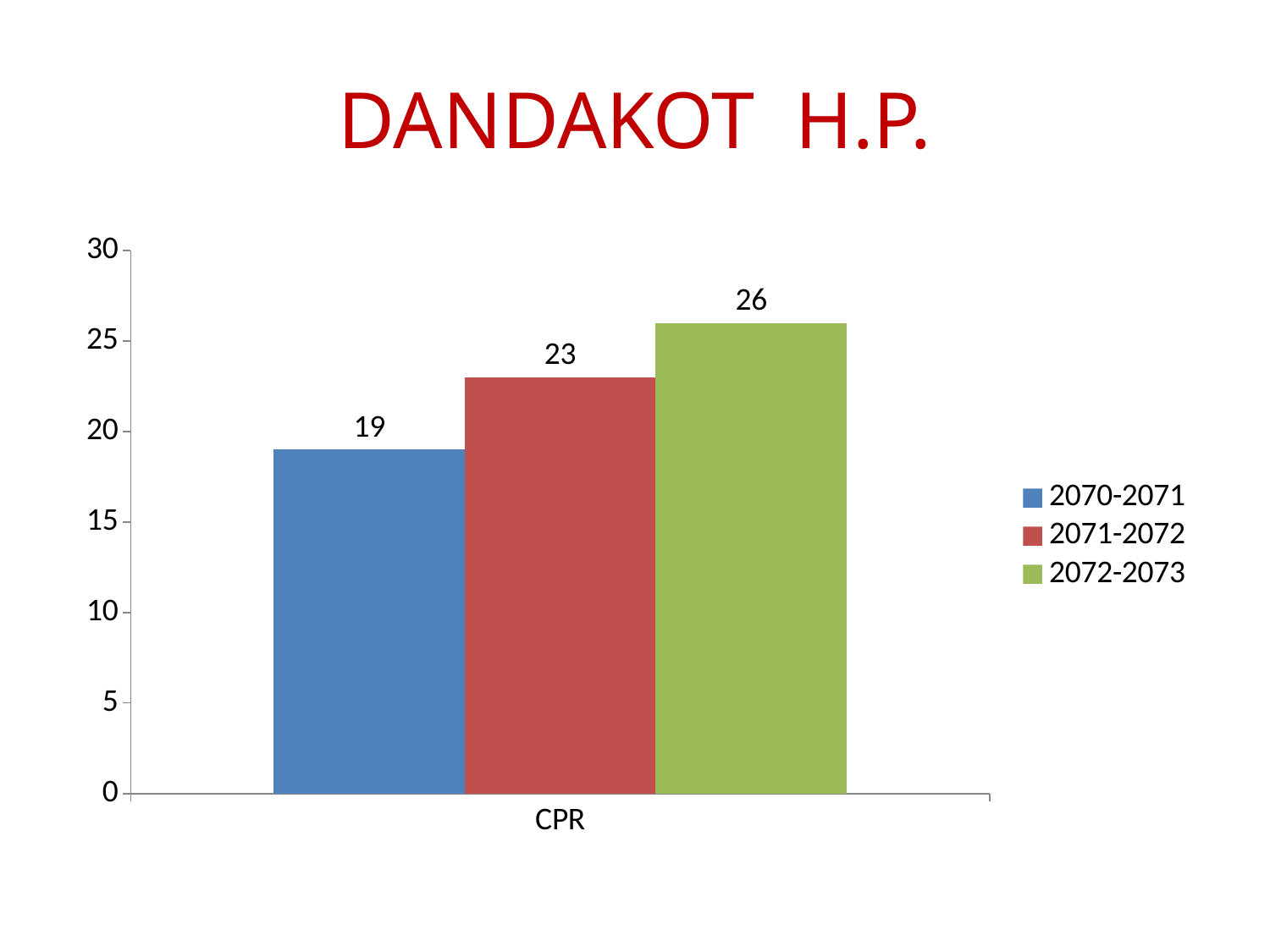
What is the CPR value for 2072-2073? 26 What is the CPR value for 2071-2072? 23 Which is larger, the CPR value for 2071-2072 or for 2072-2073? 2072-2073 How many series does the legend list? 3 What is the title of the slide? DANDAKOT H.P. Is the CPR value for 2070-2071 greater or less than 20? less What is the difference between the CPR values for 2072-2073 and 2070-2071? 7 Which series has the lowest CPR value? 2070-2071 What kind of chart is shown on the slide? bar chart Which series has the highest CPR value? 2072-2073 What is the CPR value for 2070-2071? 19 What is the difference between the CPR values for 2071-2072 and 2070-2071? 4